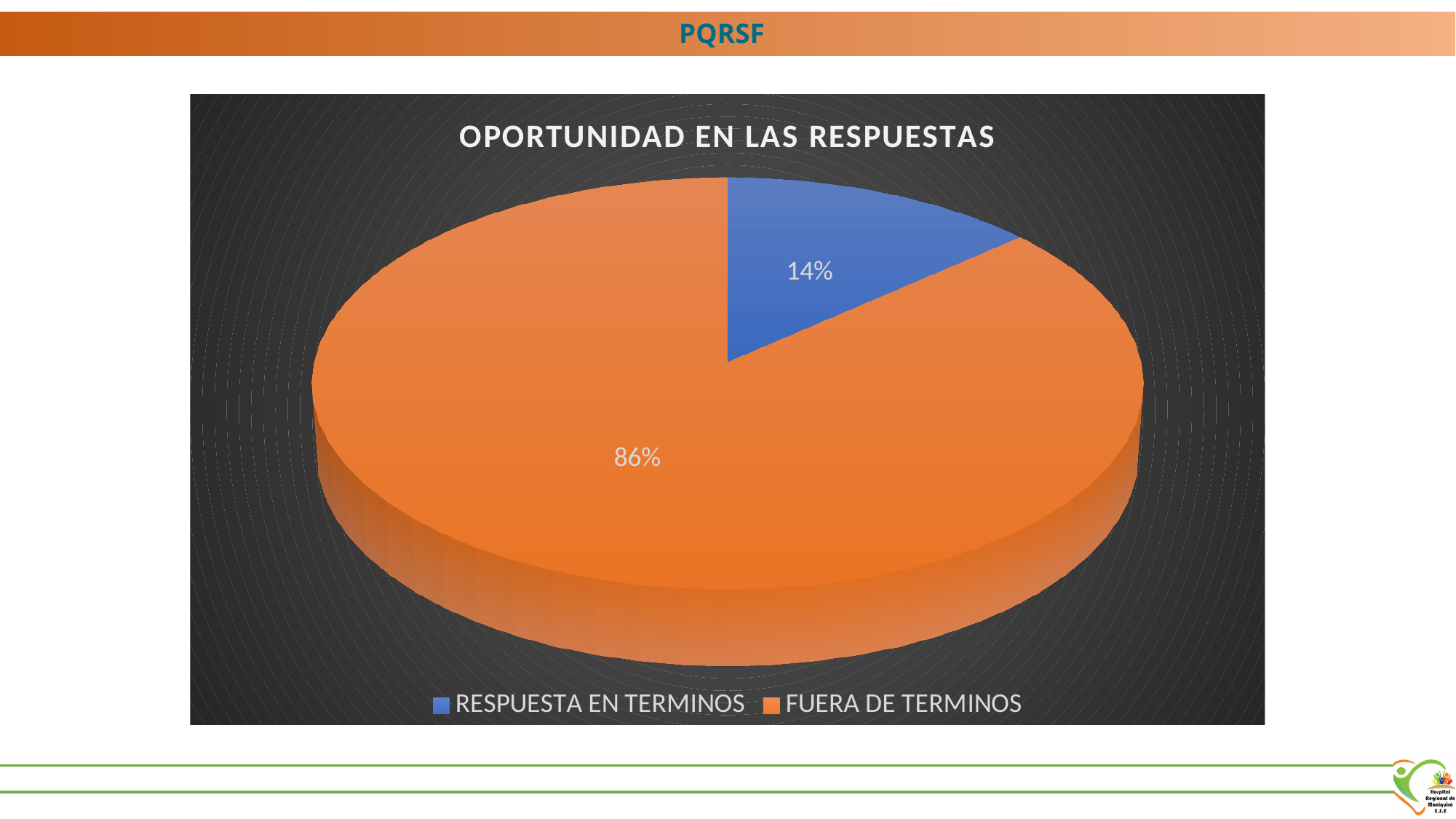
Which category has the largest share of the pie? FUERA DE TERMINOS How many categories does the pie chart have? 2 What colour is the slice for RESPUESTA EN TERMINOS? Blue Which is larger, RESPUESTA EN TERMINOS or FUERA DE TERMINOS? FUERA DE TERMINOS What percentage is shown for FUERA DE TERMINOS? 86% Which category has the smallest share of the pie? RESPUESTA EN TERMINOS What type of chart is shown on the slide? Pie chart What is the difference in percentage points between FUERA DE TERMINOS and RESPUESTA EN TERMINOS? 72 How many entries does the legend list? 2 What is the title of the chart? OPORTUNIDAD EN LAS RESPUESTAS What percentage is shown for RESPUESTA EN TERMINOS? 14% What share of the pie does FUERA DE TERMINOS represent? 86%